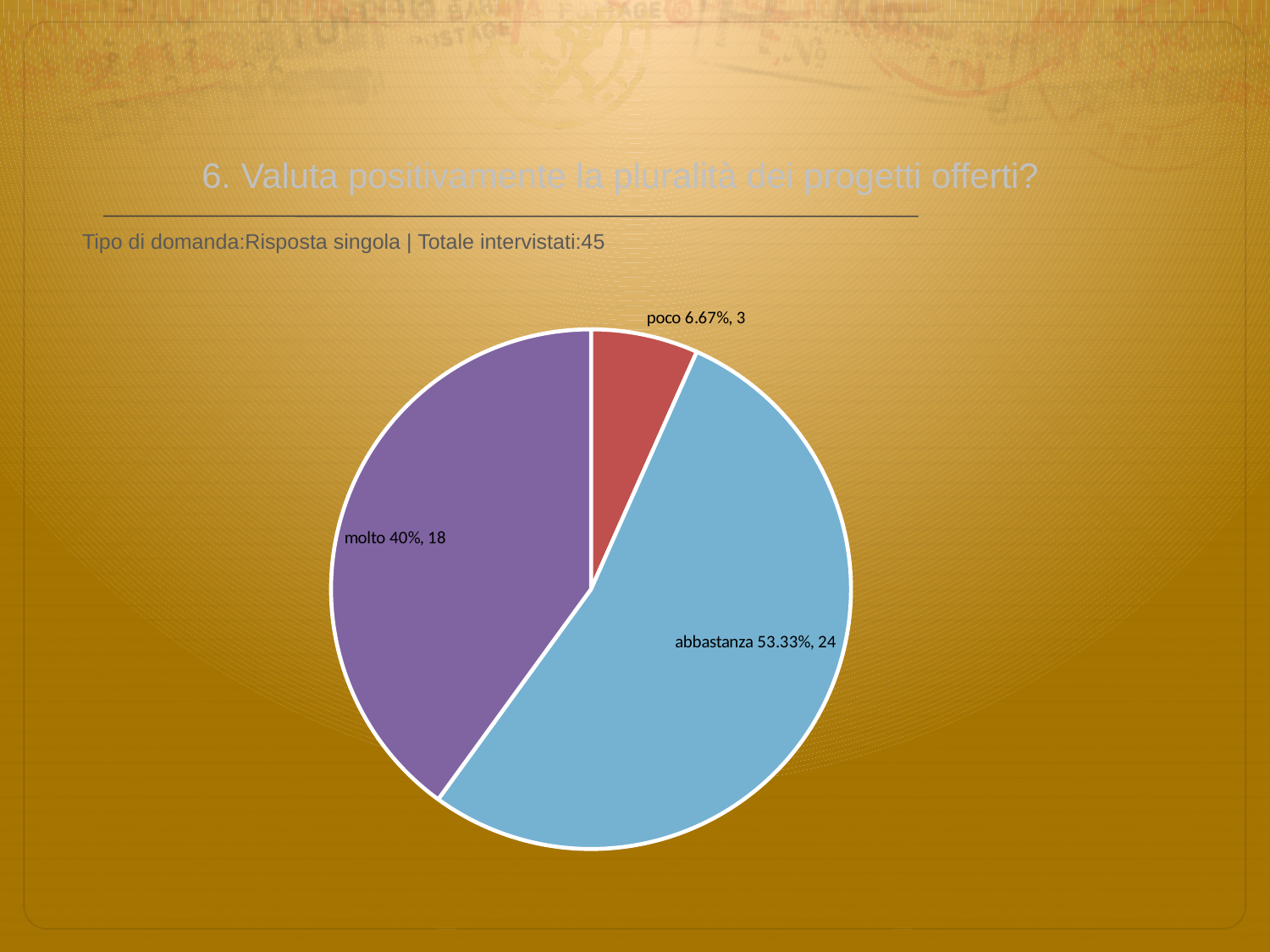
What percentage share does the 'poco' slice have? 6.67% How many respondents answered 'abbastanza'? 24 Which category has the smallest slice of the pie? poco What percentage share does the 'abbastanza' slice have? 53.33% How many slices does the pie chart have? 3 What kind of chart is shown on the slide? pie chart How many respondents answered 'molto'? 18 Which category has the largest slice of the pie? abbastanza What is the difference in respondent count between 'abbastanza' and 'molto'? 6 How many respondents answered 'poco'? 3 Which has more respondents, 'molto' or 'poco'? molto What percentage share does the 'molto' slice have? 40%